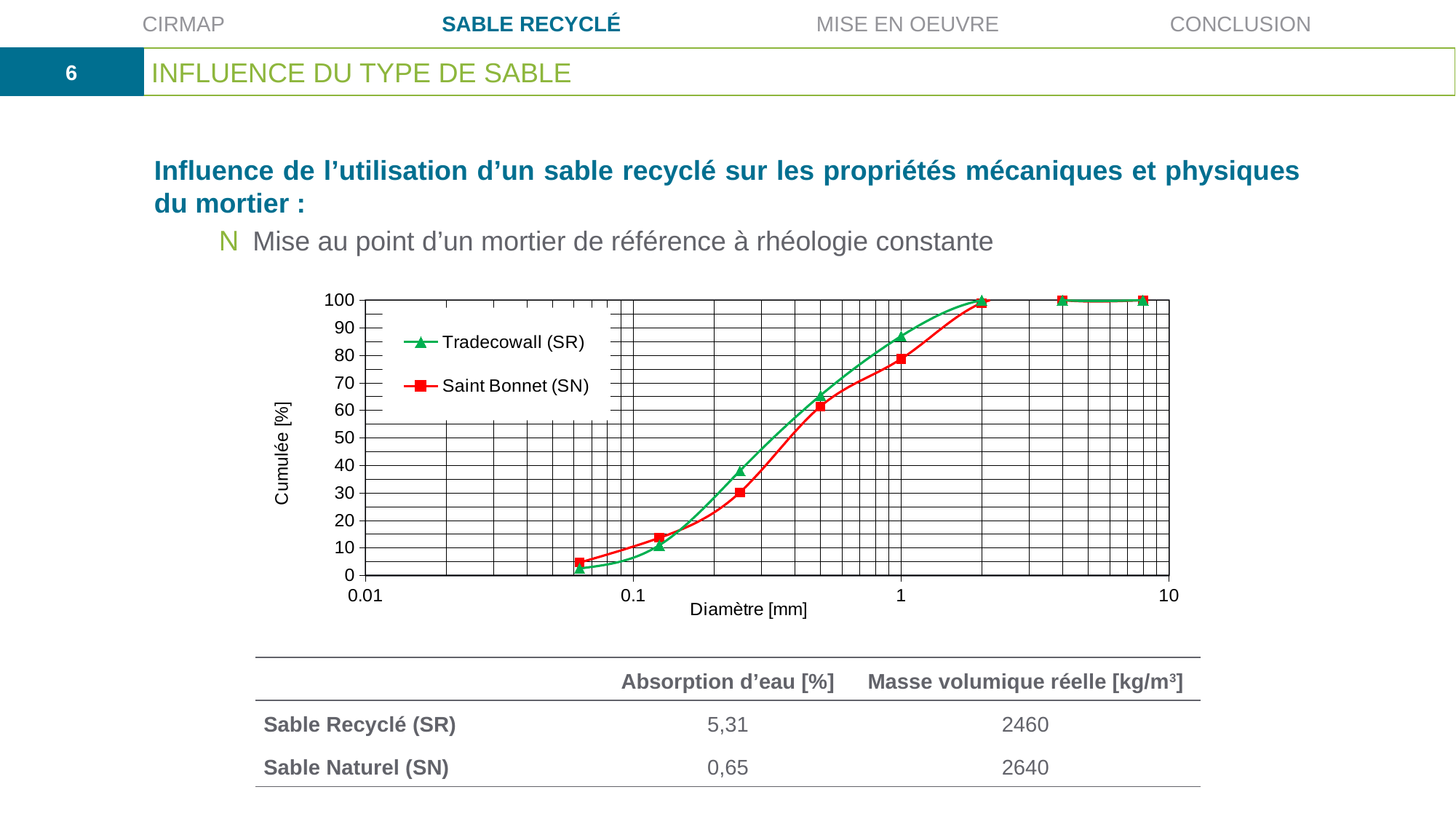
At a diameter of 1 mm, which series has the higher cumulative value, Tradecowall (SR) or Saint Bonnet (SN)? Tradecowall (SR) What is the title of the x axis of the chart? Diamètre [mm] How many series does the chart legend list? 2 Which two series are listed in the chart legend? Tradecowall (SR) and Saint Bonnet (SN) Do the values of the Tradecowall (SR) series rise or fall as the diameter increases? rise Is the cumulative value for Saint Bonnet (SN) at a diameter of 1 mm greater or less than 70? greater What kind of chart is shown on the slide? line chart At a diameter of 0.25 mm, which series has the higher cumulative value, Tradecowall (SR) or Saint Bonnet (SN)? Tradecowall (SR) Is the cumulative value for Tradecowall (SR) at a diameter of 0.25 mm greater or less than 50? less How many data points are plotted for the Saint Bonnet (SN) series? 8 Is the cumulative value for Saint Bonnet (SN) at a diameter of 0.125 mm greater or less than 20? less